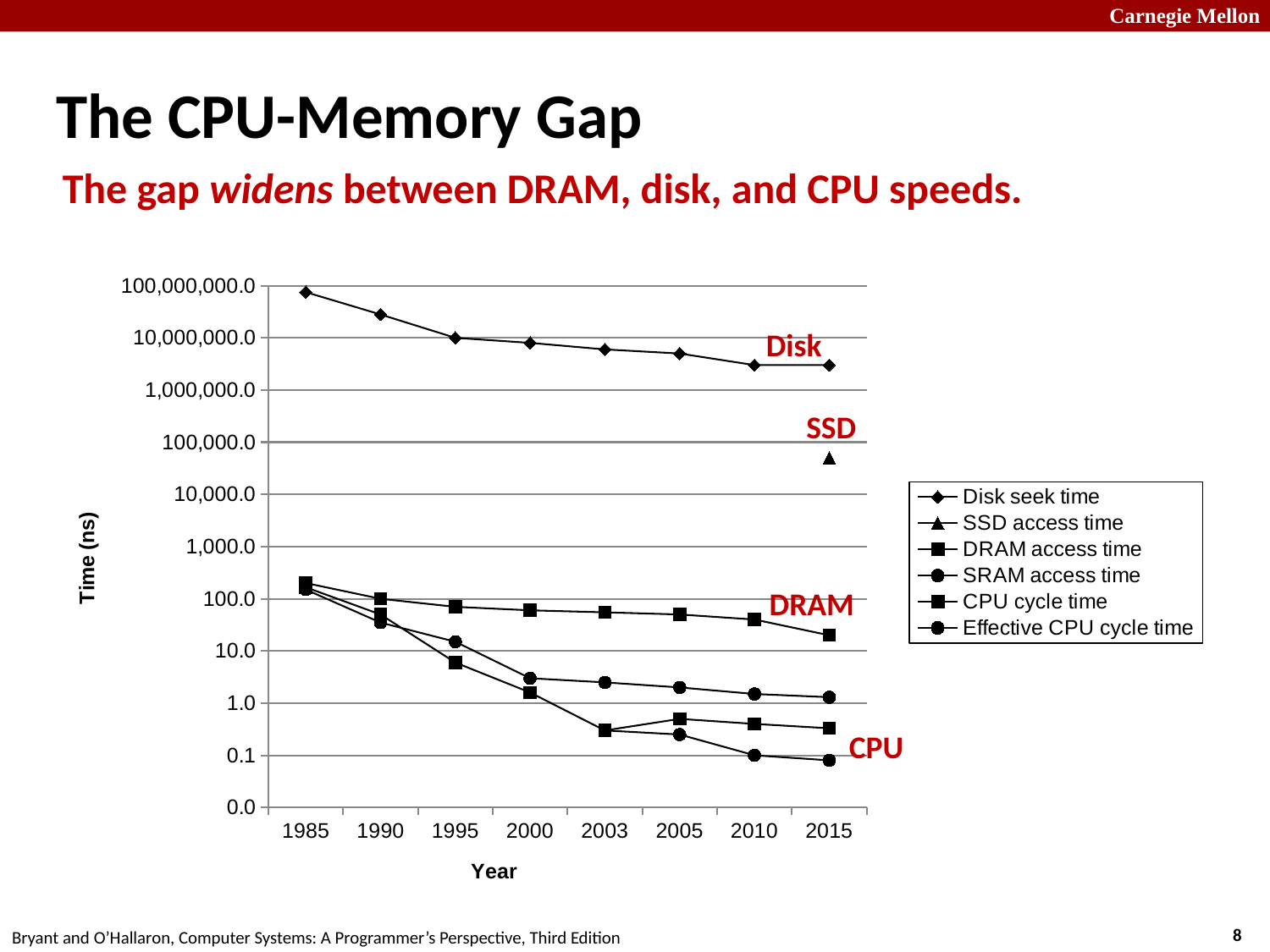
Which series has the lowest value in 2015? Effective CPU cycle time Is the SSD access time in 2015 greater or less than 100,000.0? less What is the label of the y axis? Time (ns) How many years are shown along the x axis? 8 What kind of chart is shown on the slide? line chart Does the Disk seek time rise or fall from 1985 to 2015? fall In 2015, which is larger: the SSD access time or the DRAM access time? SSD access time Is the DRAM access time in 2015 greater or less than 10.0? greater How many series does the legend list? 6 Which series has the highest values across all years? Disk seek time Is the Disk seek time in 1985 greater or less than 10,000,000.0? greater What is the label of the x axis? Year